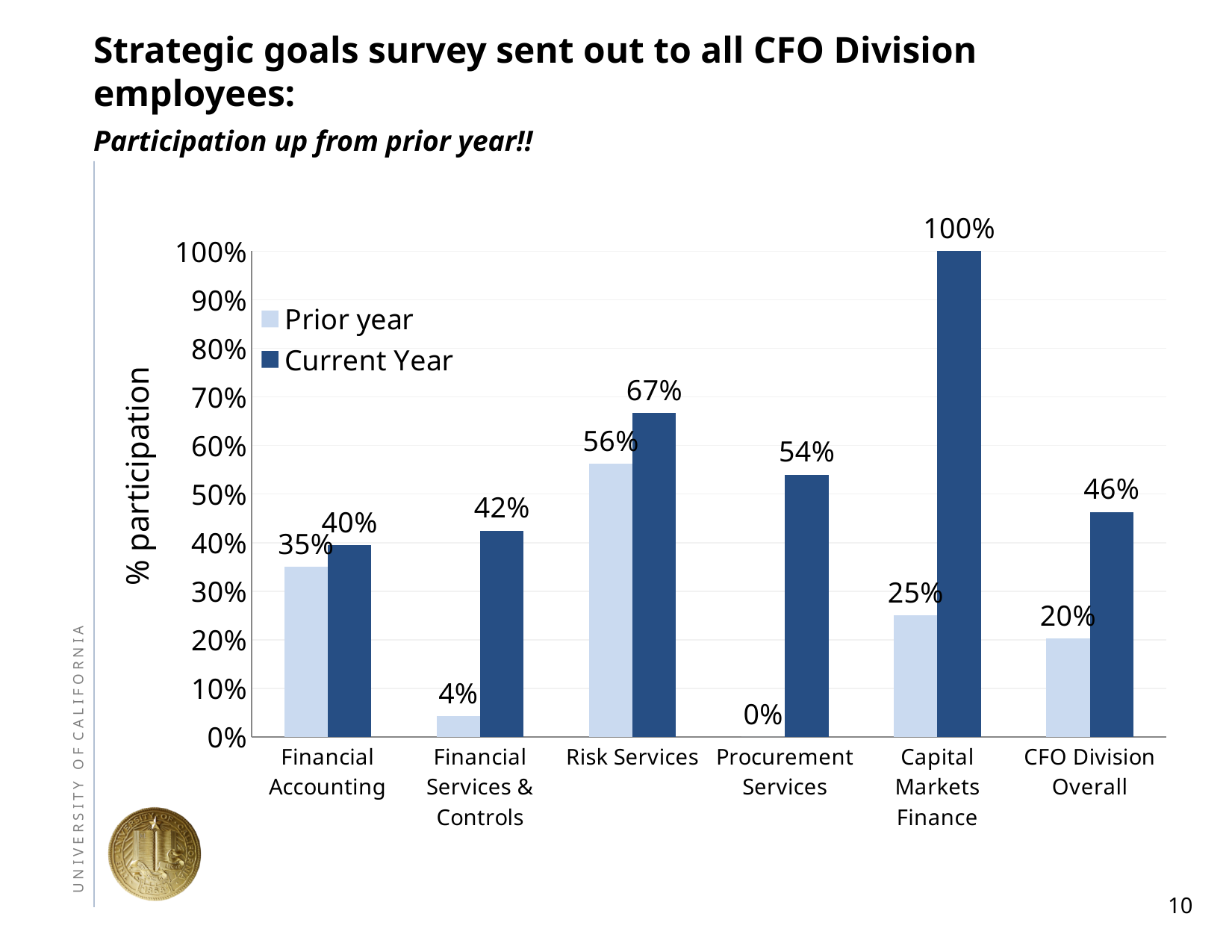
How many series does the legend list? 2 What is the difference between the Current Year and Prior year participation for Financial Services & Controls? 38% What is the Prior year participation for Procurement Services? 0% How many categories are shown on the x axis? 6 What is the Prior year participation for Risk Services? 56% What is the Current Year participation for Capital Markets Finance? 100% What is the Current Year participation for CFO Division Overall? 46% Which category has the lowest Prior year participation? Procurement Services Which category has the highest Current Year participation? Capital Markets Finance Which is larger: the Current Year participation for Risk Services or for Procurement Services? Risk Services What kind of chart is shown on the slide? Bar chart What is the label of the y axis? % participation